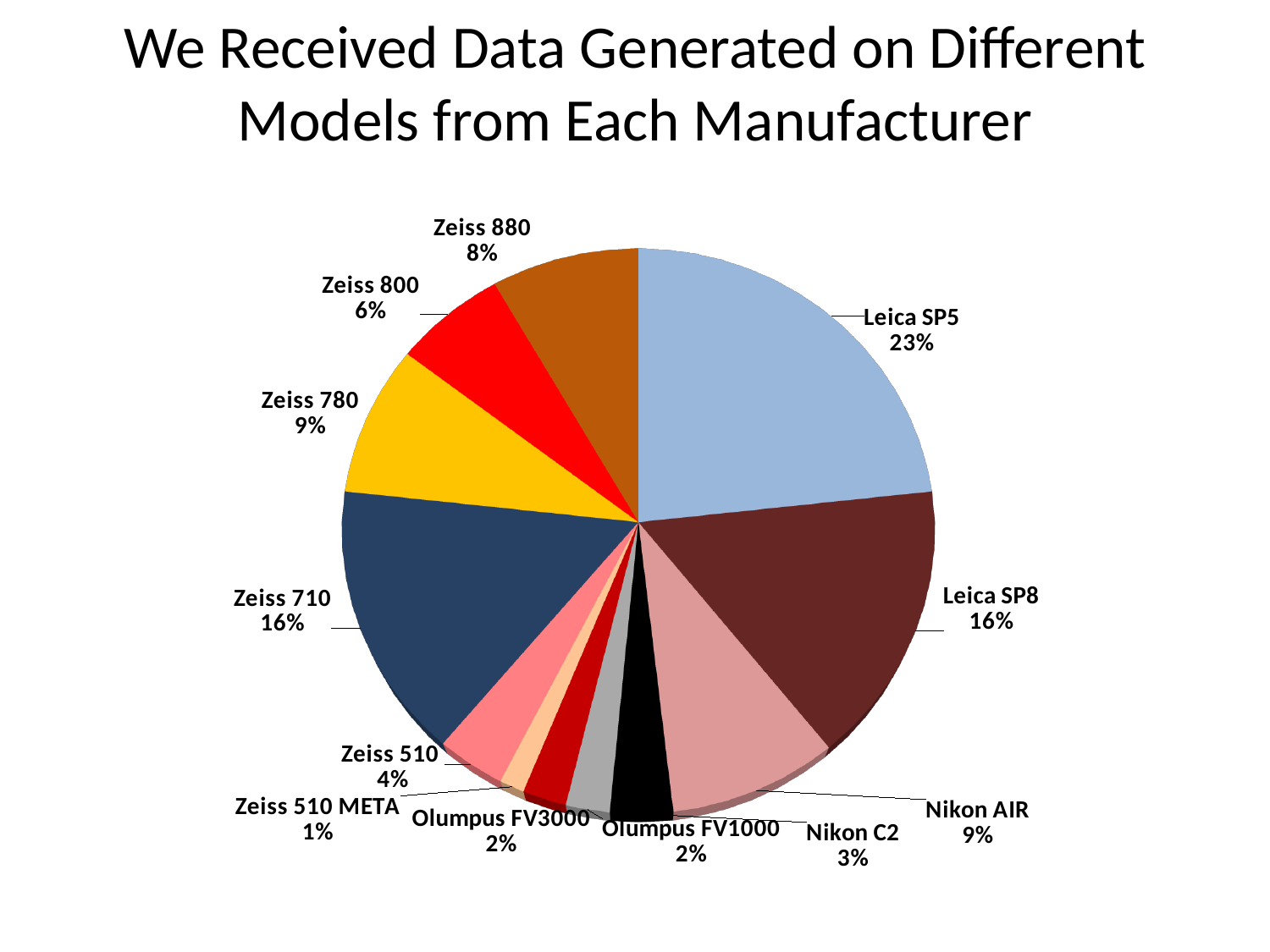
How many models (slices) are shown in the pie chart? 12 What is the difference in percentage points between Zeiss 780 and Zeiss 800? 3 What is the value shown for Zeiss 710? 16% Which model has the smallest slice of the pie? Zeiss 510 META What kind of chart is shown on the slide? pie chart Which model has the largest slice of the pie? Leica SP5 What share of the pie does Leica SP5 have? 23% What is the title of the slide containing the pie chart? We Received Data Generated on Different Models from Each Manufacturer Which is larger, the share for Zeiss 510 or the share for Nikon C2? Zeiss 510 What is the value shown for Zeiss 880? 8% What is the difference in percentage points between Leica SP5 and Leica SP8? 7 What is the value shown for Nikon AIR? 9%